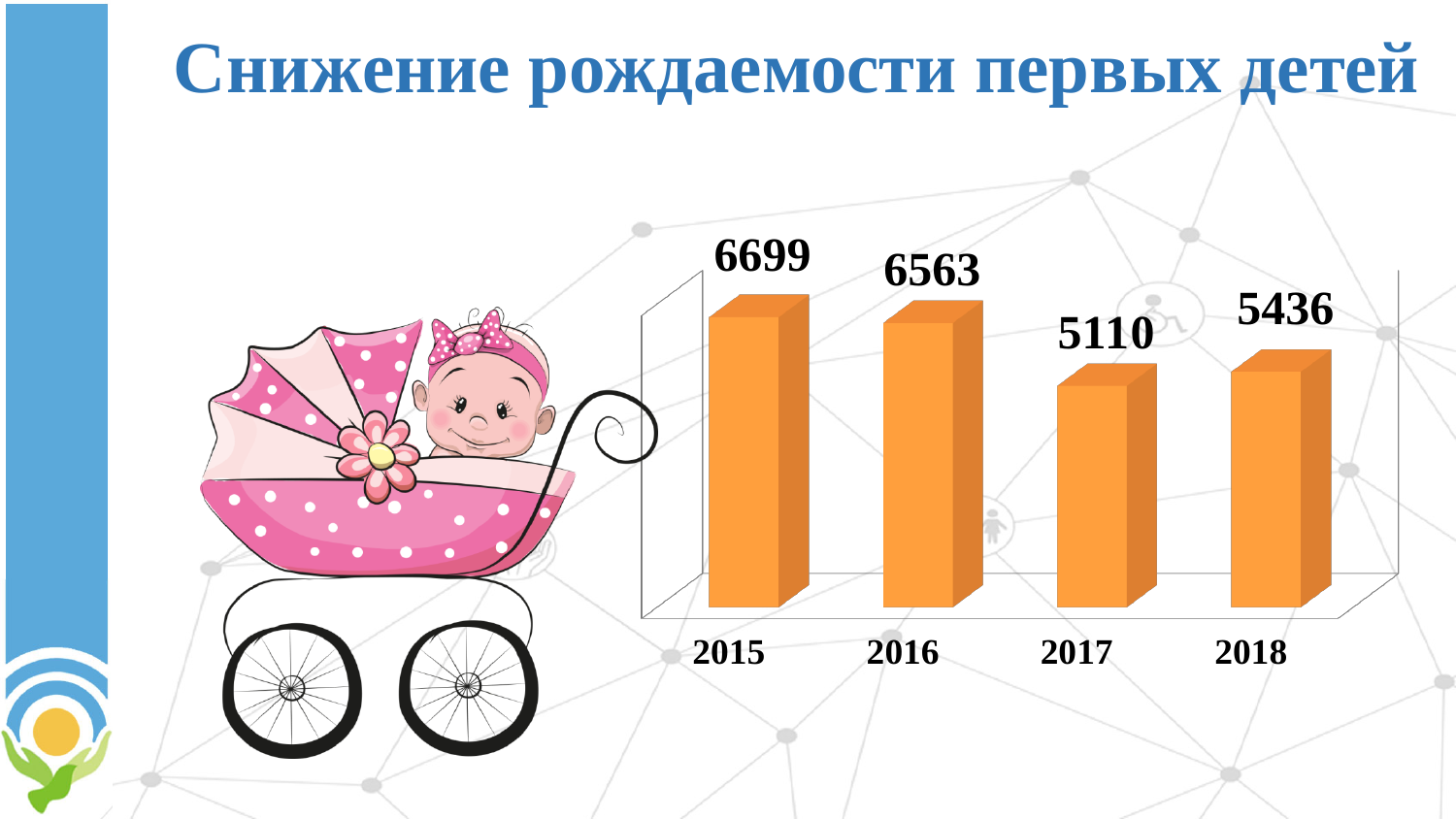
What is the value for 2015? 6699 What is the value for 2017? 5110 What is the value for 2016? 6563 What is the difference between the values for 2015 and 2018? 1263 What is the difference between the values for 2016 and 2017? 1453 How many years are shown on the chart? 4 What is the value for 2018? 5436 What is the title of the slide? Снижение рождаемости первых детей Which year has the lowest value? 2017 Which year has the highest value? 2015 What kind of chart is shown on the slide? bar chart Which is larger, the value for 2017 or the value for 2018? 2018